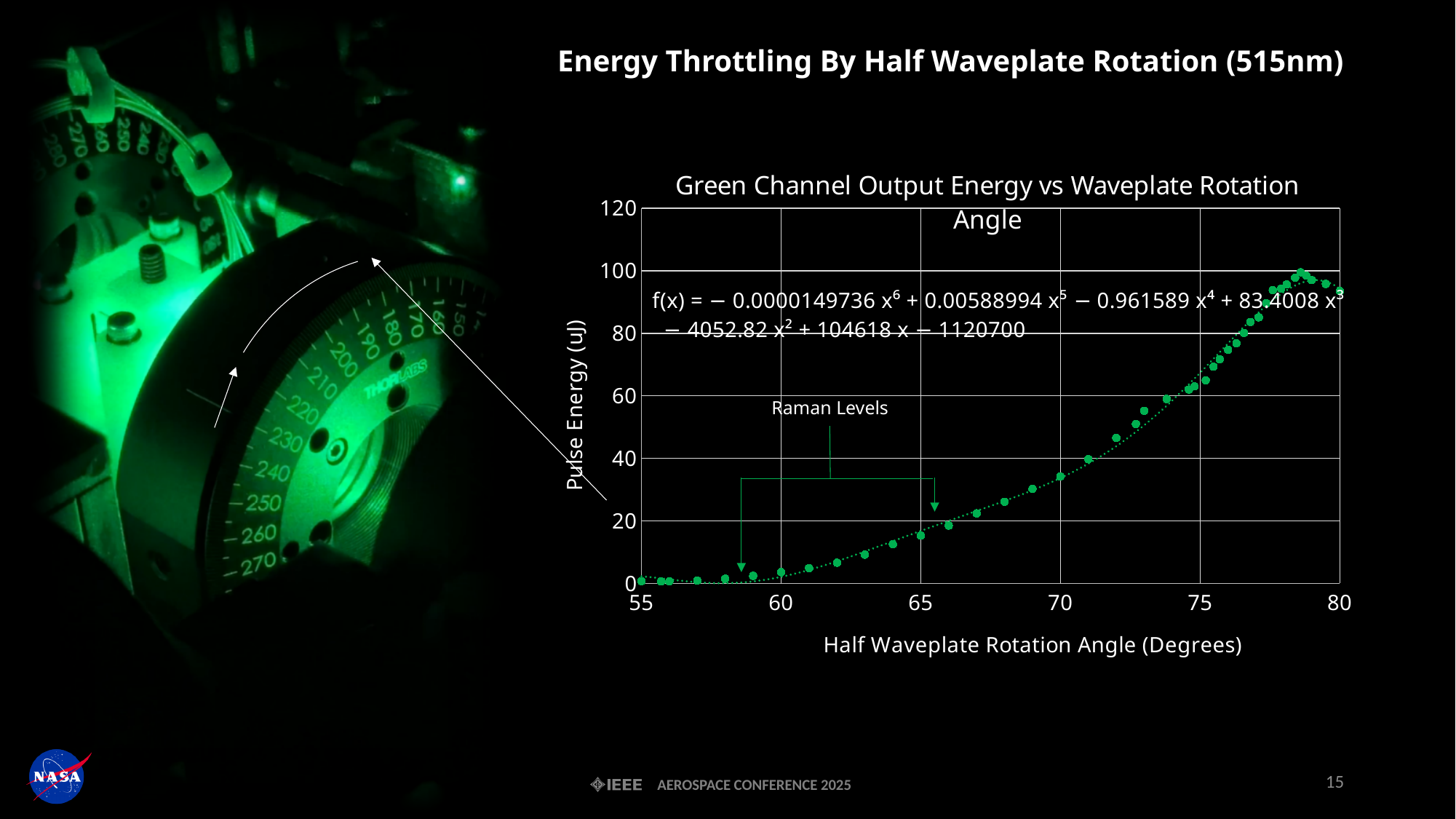
Is the pulse energy at a rotation angle of 75 degrees greater or less than 60? greater Does the pulse energy generally rise or fall as the rotation angle increases from 55 to 78 degrees? rise Is the pulse energy at a rotation angle of 60 degrees greater or less than 20? less What is the label of the x axis of the chart? Half Waveplate Rotation Angle (Degrees) Which is larger, the pulse energy at 65 degrees or at 75 degrees? 75 degrees What kind of chart is shown on the slide? Scatter chart Is the pulse energy at a rotation angle of 65 degrees greater or less than 20? less What is the title of the chart? Green Channel Output Energy vs Waveplate Rotation Angle What is the highest value shown on the y axis of the chart? 120